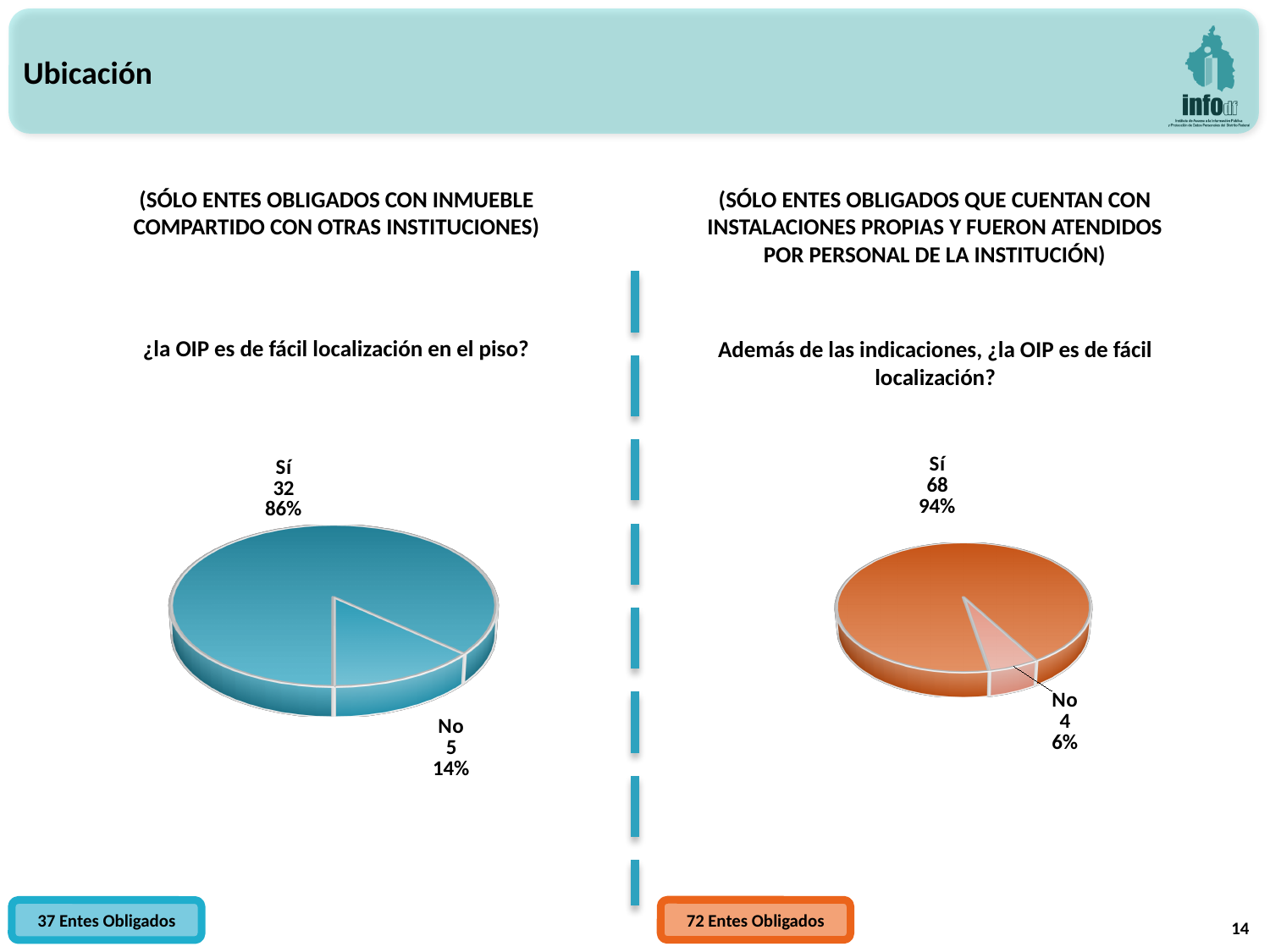
In the right chart (Además de las indicaciones, ¿la OIP es de fácil localización?), how many entities answered No? 4 In the left chart (¿la OIP es de fácil localización en el piso?), which answer has the largest slice? Sí In the left chart (¿la OIP es de fácil localización en el piso?), how many entities answered Sí? 32 How many slices does the right chart (Además de las indicaciones, ¿la OIP es de fácil localización?) have? 2 Which chart has more Sí responses, the left chart or the right chart? The right chart In the left chart (¿la OIP es de fácil localización en el piso?), what percentage answered No? 14% In the right chart (Además de las indicaciones, ¿la OIP es de fácil localización?), what percentage answered Sí? 94% In the right chart (Además de las indicaciones, ¿la OIP es de fácil localización?), what is the difference between the number of Sí and No responses? 64 In the right chart (Además de las indicaciones, ¿la OIP es de fácil localización?), which answer has the smallest slice? No What is the total number of entities represented in the left chart (¿la OIP es de fácil localización en el piso?)? 37 In the left chart (¿la OIP es de fácil localización en el piso?), what is the difference between the number of Sí and No responses? 27 What type of chart is used on the left side of the slide? Pie chart